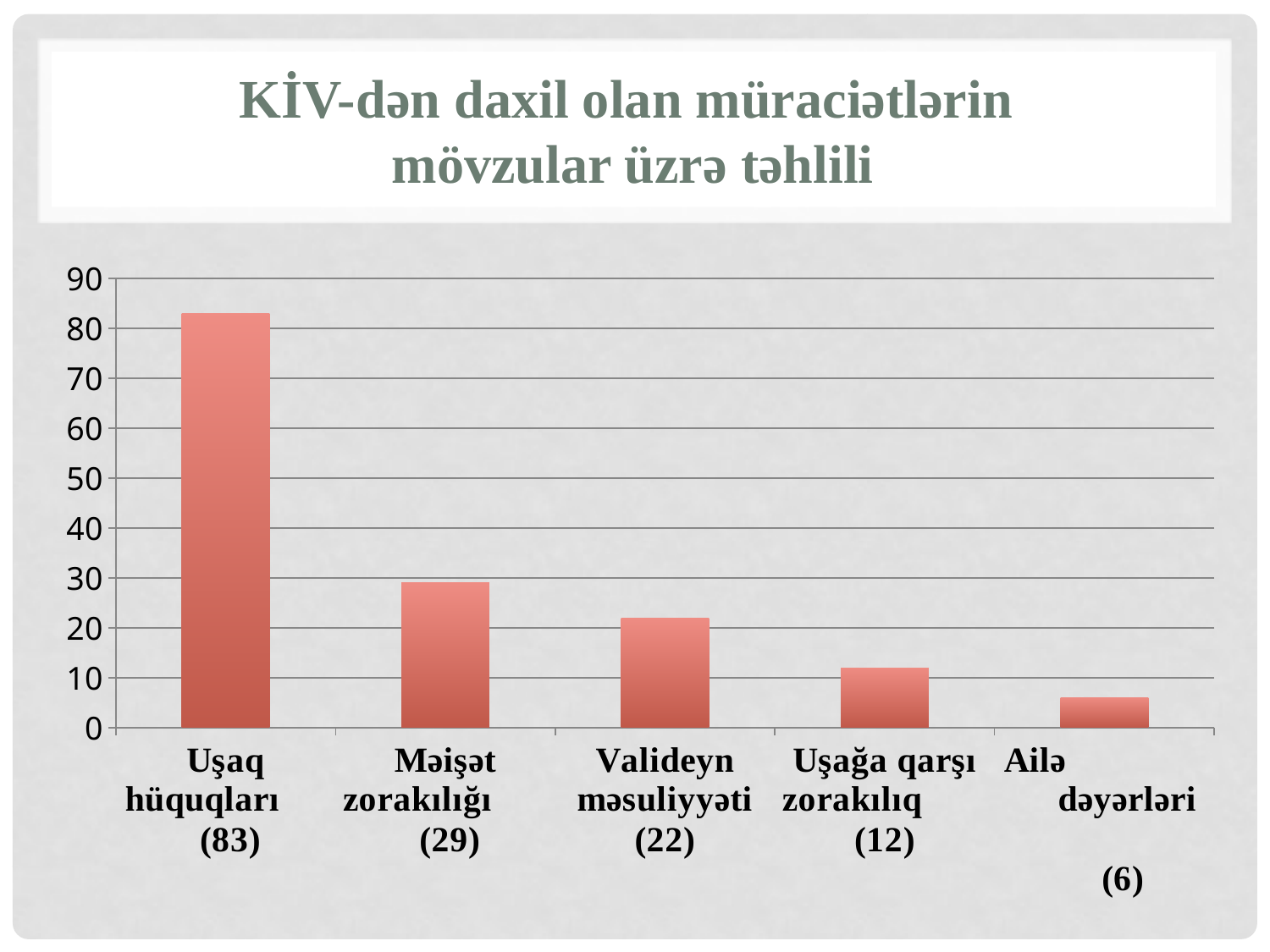
How many categories are shown in the chart? 5 What is the title of the slide? KİV-dən daxil olan müraciətlərin mövzular üzrə təhlili What is the value for Valideyn məsuliyyəti? 22 What is the value for Uşaq hüquqları? 83 Which category has the lowest value? Ailə dəyərləri What is the value for Ailə dəyərləri? 6 Is the value for Uşaq hüquqları greater or less than 80? greater Which is larger, the value for Valideyn məsuliyyəti or the value for Uşağa qarşı zorakılıq? Valideyn məsuliyyəti What kind of chart is shown on the slide? Bar chart Which category has the highest value? Uşaq hüquqları What is the value for Məişət zorakılığı? 29 What is the difference between the values for Uşaq hüquqları and Məişət zorakılığı? 54